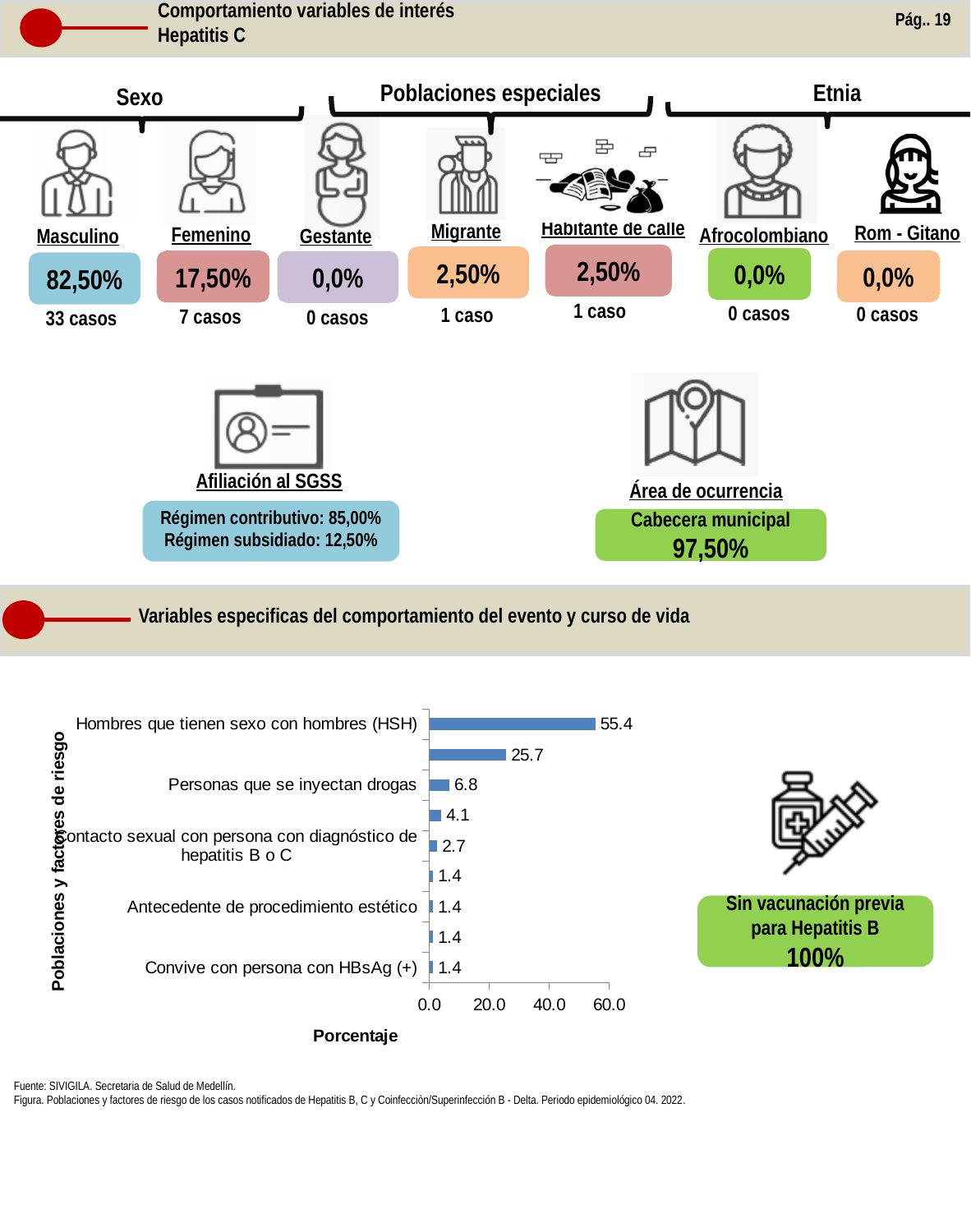
In the bar chart, what is the difference between the values for Hombres que tienen sexo con hombres (HSH) and Personas que se inyectan drogas? 48.6 In the bar chart, is the value for Hombres que tienen sexo con hombres (HSH) greater or less than 40.0? greater What is the title of the horizontal axis of the bar chart? Porcentaje In the bar chart, what is the value for Personas que se inyectan drogas? 6.8 What kind of chart is shown at the bottom of the slide? bar chart Which category has the highest value in the bar chart? Hombres que tienen sexo con hombres (HSH) In the bar chart, what is the value for Contacto sexual con persona con diagnóstico de hepatitis B o C? 2.7 In the bar chart, what is the value for Hombres que tienen sexo con hombres (HSH)? 55.4 How many bars are plotted in the bar chart? 9 In the bar chart, what is the value for Antecedente de procedimiento estético? 1.4 In the bar chart, what is the value for Convive con persona con HBsAg (+)? 1.4 In the bar chart, which is larger: the value for Personas que se inyectan drogas or the value for Contacto sexual con persona con diagnóstico de hepatitis B o C? Personas que se inyectan drogas